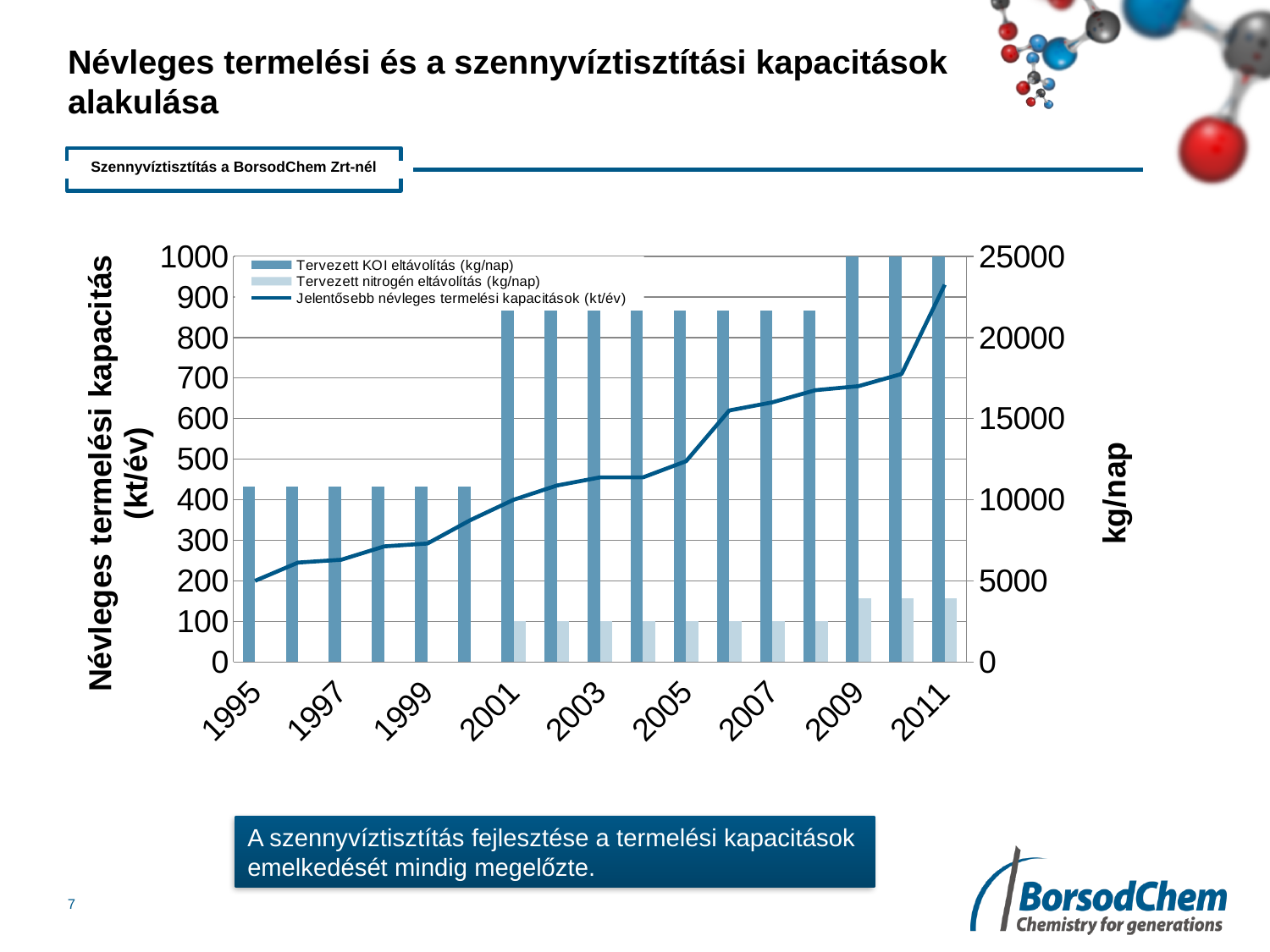
Is the Tervezett nitrogén eltávolítás (kg/nap) value for 2005 greater or less than 5000? less Is the Tervezett KOI eltávolítás (kg/nap) value for 1995 greater or less than 15000? less Does the line for Jelentősebb névleges termelési kapacitások (kt/év) rise or fall from 1995 to 2011? Rise Is the Jelentősebb névleges termelési kapacitások (kt/év) value for 2011 greater or less than 800? greater How many series does the chart legend list? 3 Which year has the larger Tervezett nitrogén eltávolítás (kg/nap) value, 2003 or 2010? 2010 Which year has the larger Tervezett KOI eltávolítás (kg/nap) value, 1997 or 2003? 2003 What is the label of the right-hand vertical axis of the chart? kg/nap What kind of chart is shown on the slide? A combined bar and line chart